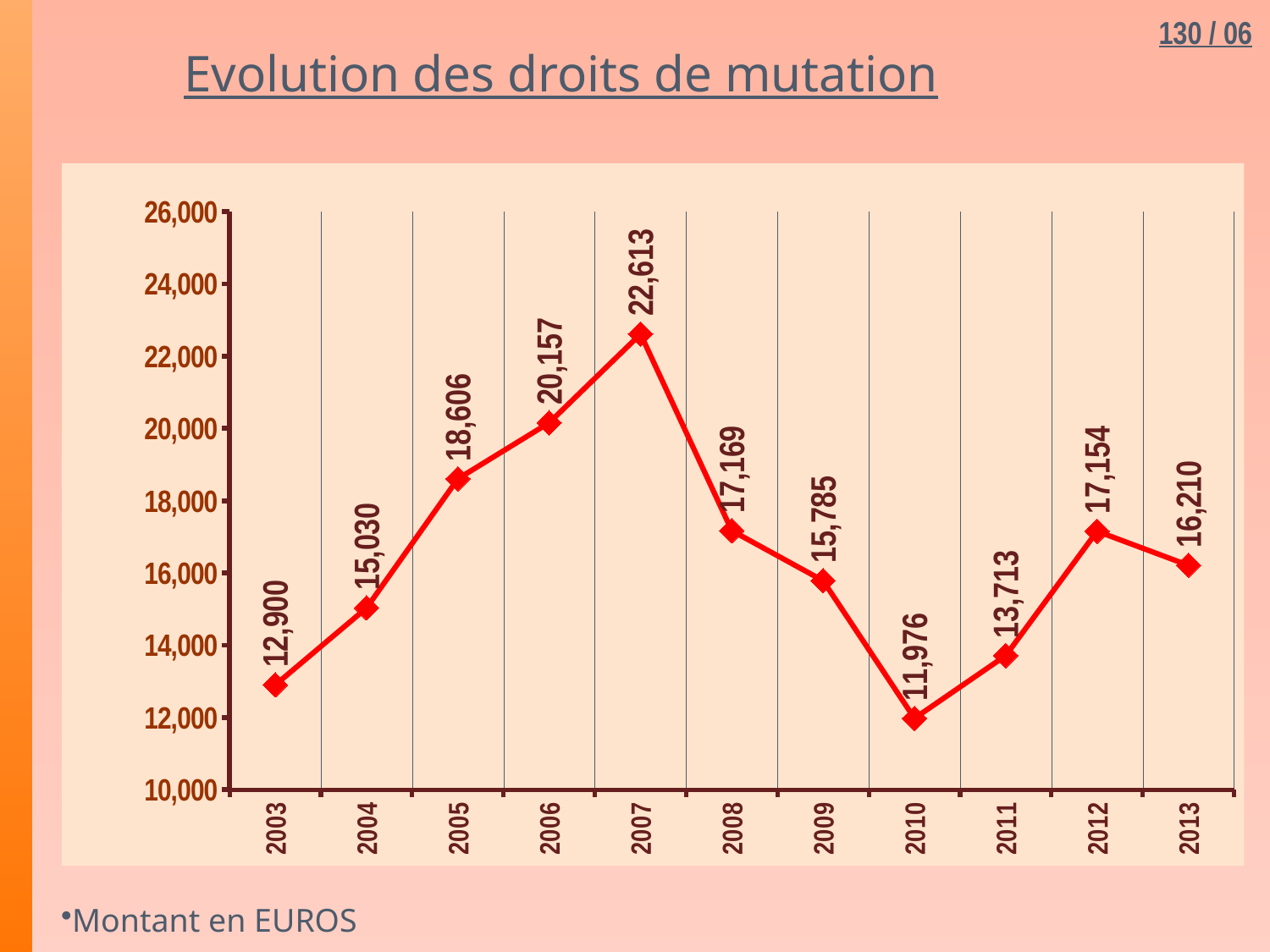
What kind of chart is shown? line chart What is the value for 2007? 22,613 Do the values rise or fall from 2003 to 2007? rise What is the value for 2010? 11,976 Which year has the highest value? 2007 Is the value for 2006 greater or less than 20,000? greater Which is larger, the value for 2005 or the value for 2009? 2005 What is the difference between the values for 2007 and 2010? 10,637 Which year has the lowest value? 2010 What is the value for 2003? 12,900 What is the title of the chart? Evolution des droits de mutation How many years are plotted on the chart? 11